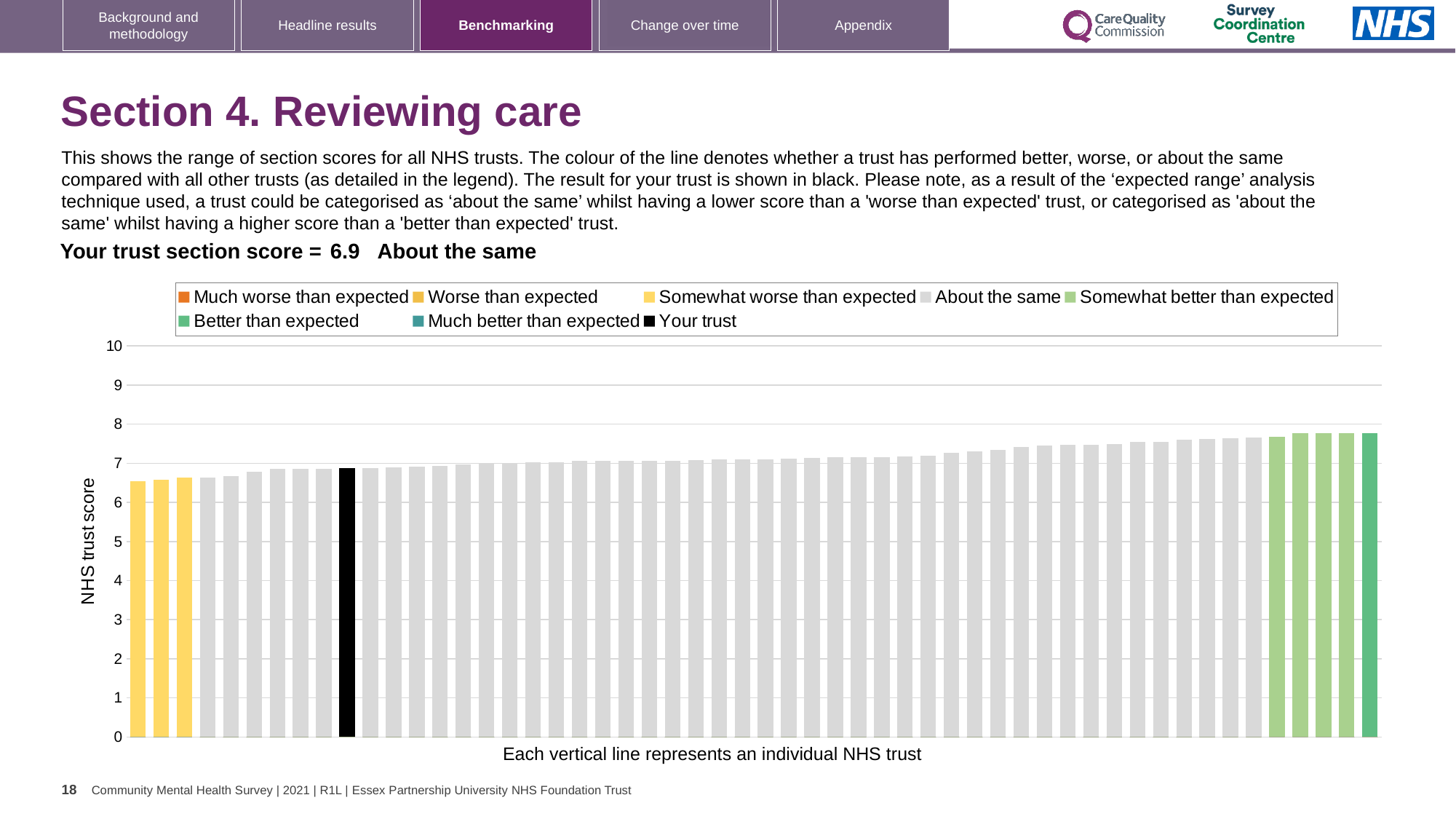
How many bars are coloured yellow (somewhat worse than expected)? 3 What is the label on the vertical axis of the chart? NHS trust score What kind of chart is shown on the slide? Bar chart Which is taller: the rightmost bar or the leftmost bar? the rightmost bar Is the value of the black bar (your trust) greater or less than 5? greater What is the section score for your trust shown on the slide? 6.9 How many entries does the chart legend list? 8 What colour is the bar representing your trust? Black Is the value of the tallest bar greater or less than 8? less Do the bar values rise or fall from left to right along the x axis? rise Which category is your trust placed in for this section? About the same Is the value of the leftmost bar greater or less than 6? greater